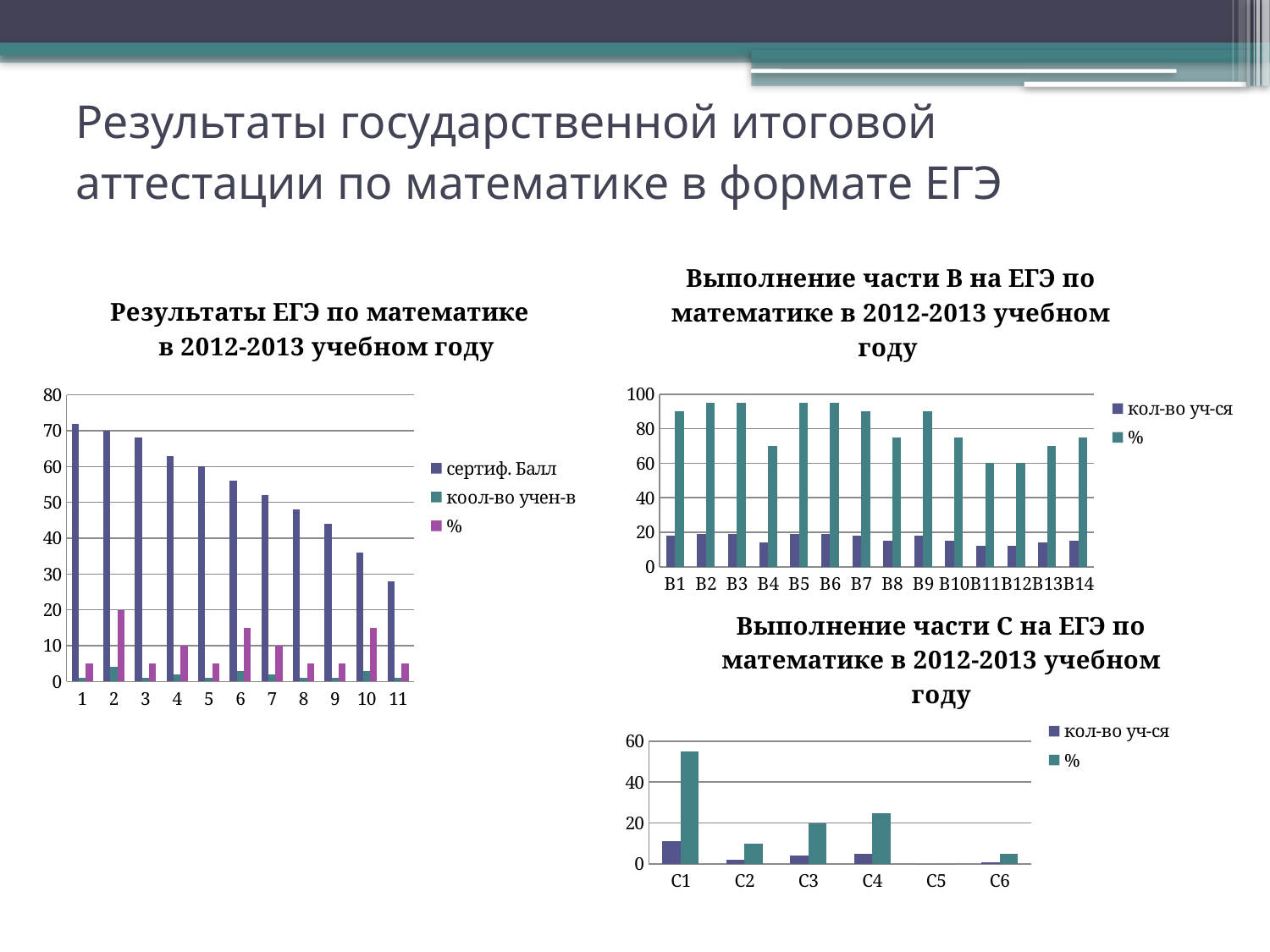
How many categories are shown on the x axis of "Результаты ЕГЭ по математике в 2012-2013 учебном году"? 11 How many series does the legend of "Результаты ЕГЭ по математике в 2012-2013 учебном году" list? 3 In "Результаты ЕГЭ по математике в 2012-2013 учебном году", which category has the lowest сертиф. Балл? 11 What type of chart is "Результаты ЕГЭ по математике в 2012-2013 учебном году"? bar chart In "Выполнение части С на ЕГЭ по математике в 2012-2013 учебном году", which is larger, the % value for C1 or for C4? C1 In "Результаты ЕГЭ по математике в 2012-2013 учебном году", is the сертиф. Балл for category 10 greater or less than 40? less In "Результаты ЕГЭ по математике в 2012-2013 учебном году", do the values of сертиф. Балл rise or fall from category 1 to category 11? fall In "Выполнение части В на ЕГЭ по математике в 2012-2013 учебном году", is the % value for B4 greater or less than 80? less In "Результаты ЕГЭ по математике в 2012-2013 учебном году", which category has the highest % value? 2 In "Выполнение части С на ЕГЭ по математике в 2012-2013 учебном году", which category has the highest % value? C1 How many categories are shown on the x axis of "Выполнение части В на ЕГЭ по математике в 2012-2013 учебном году"? 14 In "Выполнение части В на ЕГЭ по математике в 2012-2013 учебном году", is the кол-во уч-ся value for B11 greater or less than 20? less